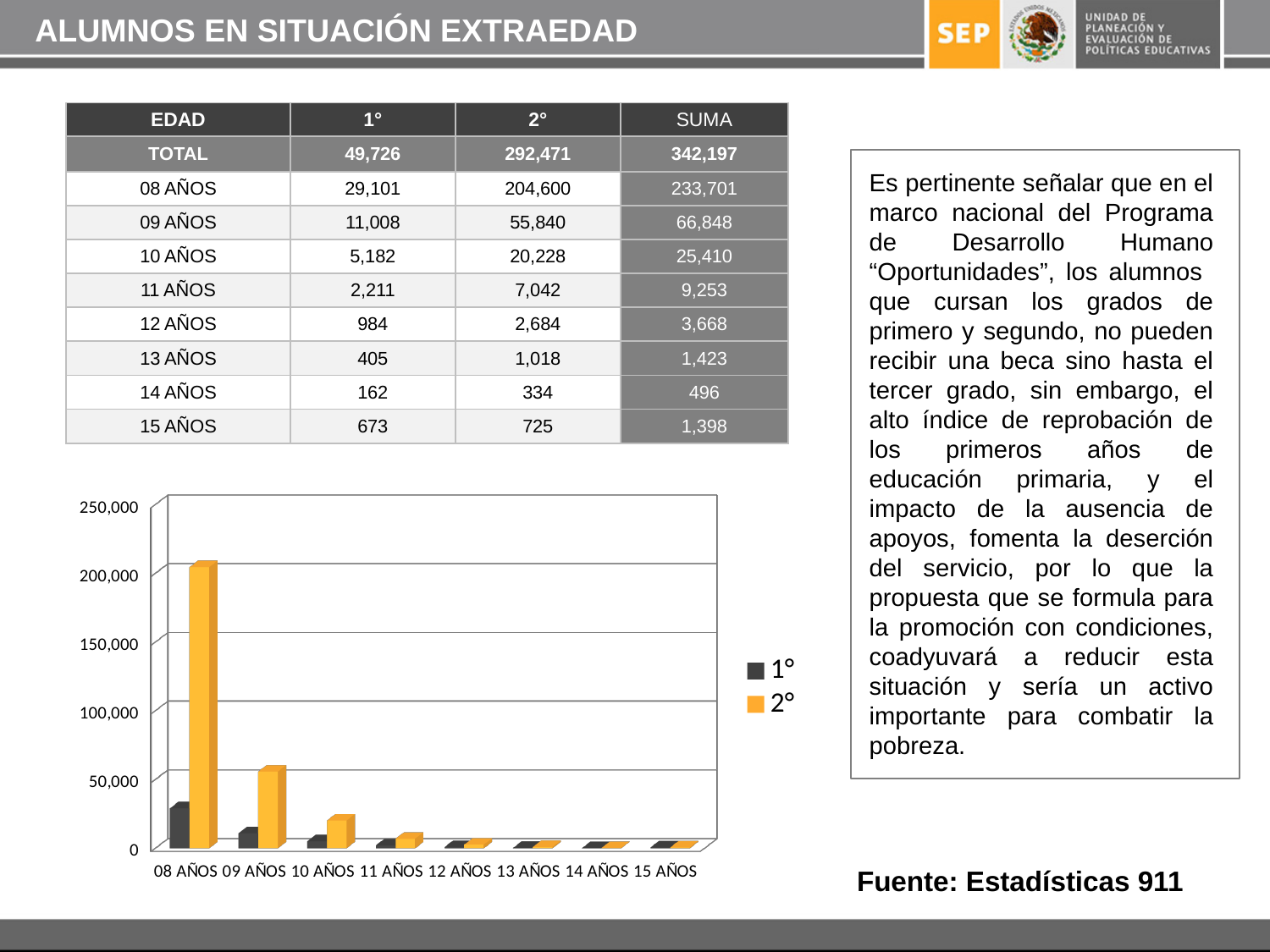
Is the value for 2° at 09 AÑOS greater or less than 100,000? less Which age category has the highest value for the 1° series in the chart? 08 AÑOS Which age category has the highest value for the 2° series in the chart? 08 AÑOS Do the 2° values rise or fall as age increases from 08 AÑOS to 12 AÑOS along the x axis? fall Is the value for 1° at 08 AÑOS greater or less than 50,000? less What is the value for 2° at 08 AÑOS, as printed in the table on the slide? 204,600 Is the value for 2° at 08 AÑOS greater or less than 200,000? greater How many age categories are shown on the x axis of the chart? 8 How many series does the chart legend list? 2 Which is larger at 10 AÑOS, the 1° bar or the 2° bar? 2° What colour represents the 2° series in the chart? orange What kind of chart is shown on the slide? bar chart